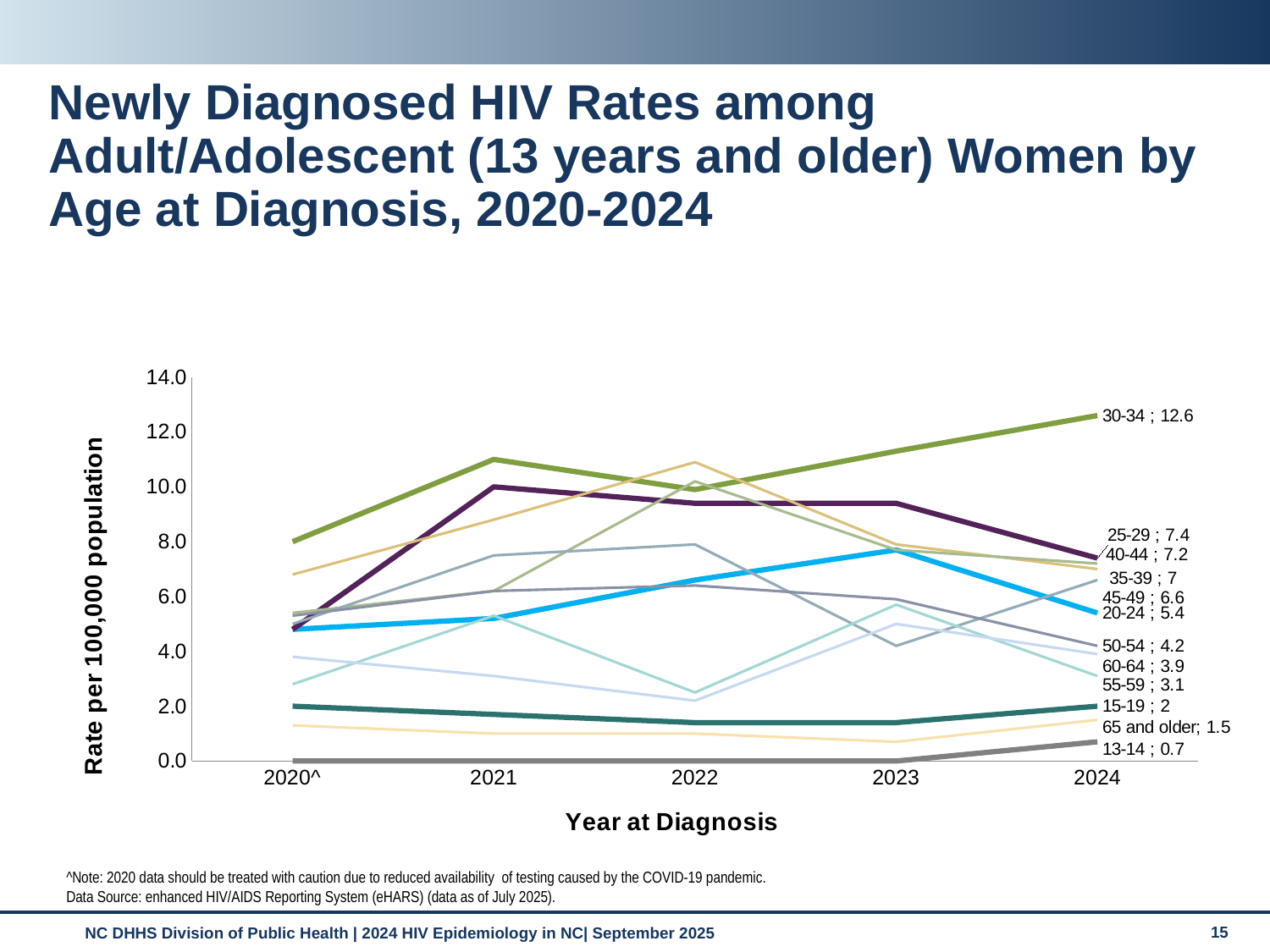
What is the 2024 rate for the 30-34 age group? 12.6 What is the 2024 rate for the 20-24 age group? 5.4 Does the rate for the 30-34 age group rise or fall from 2022 to 2024? Rises What is the 2024 rate for women aged 65 and older? 1.5 Which age group has the lowest rate in 2024? 13-14 How many age-group series are plotted on the chart? 12 What type of chart is shown on the slide? Line chart How many years are shown on the x axis? 5 Which age group has the highest rate in 2024? 30-34 In 2024, which age group has the higher rate: 40-44 or 35-39? 40-44 Is the rate for the 30-34 age group in 2021 greater or less than 10.0? greater What is the difference between the 2024 rates for the 30-34 and 25-29 age groups? 5.2